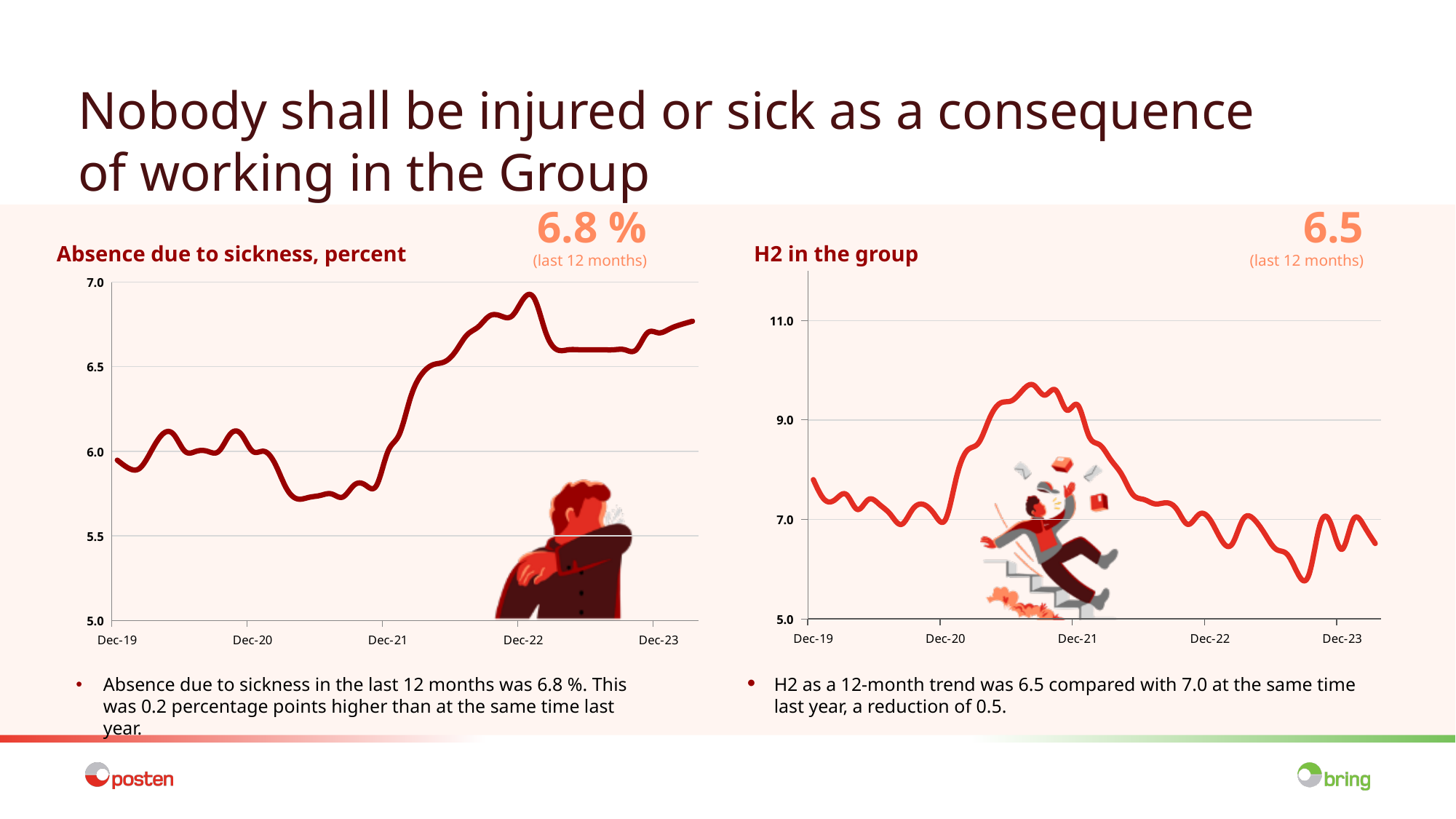
On the 'H2 in the group' chart, which is higher: the value at Dec-21 or the value at Dec-23? Dec-21 On the 'H2 in the group' chart, is the value at Dec-19 greater or less than 7.0? greater On the 'Absence due to sickness, percent' chart, what is the value shown for the last 12 months? 6.8 % On the 'H2 in the group' chart, does the line overall rise or fall from Dec-21 to Dec-23? fall How many date labels are shown on the x axis of the 'Absence due to sickness, percent' chart? 5 On the 'H2 in the group' chart, what is the value shown for the last 12 months? 6.5 What kind of chart is the 'H2 in the group' chart? line chart On the 'H2 in the group' chart, is the highest point of the line greater or less than 11.0? less What kind of chart is the 'Absence due to sickness, percent' chart? line chart On the 'Absence due to sickness, percent' chart, is the value at Dec-22 greater or less than 6.5? greater On the 'Absence due to sickness, percent' chart, which is higher: the value at Dec-20 or the value at Dec-22? Dec-22